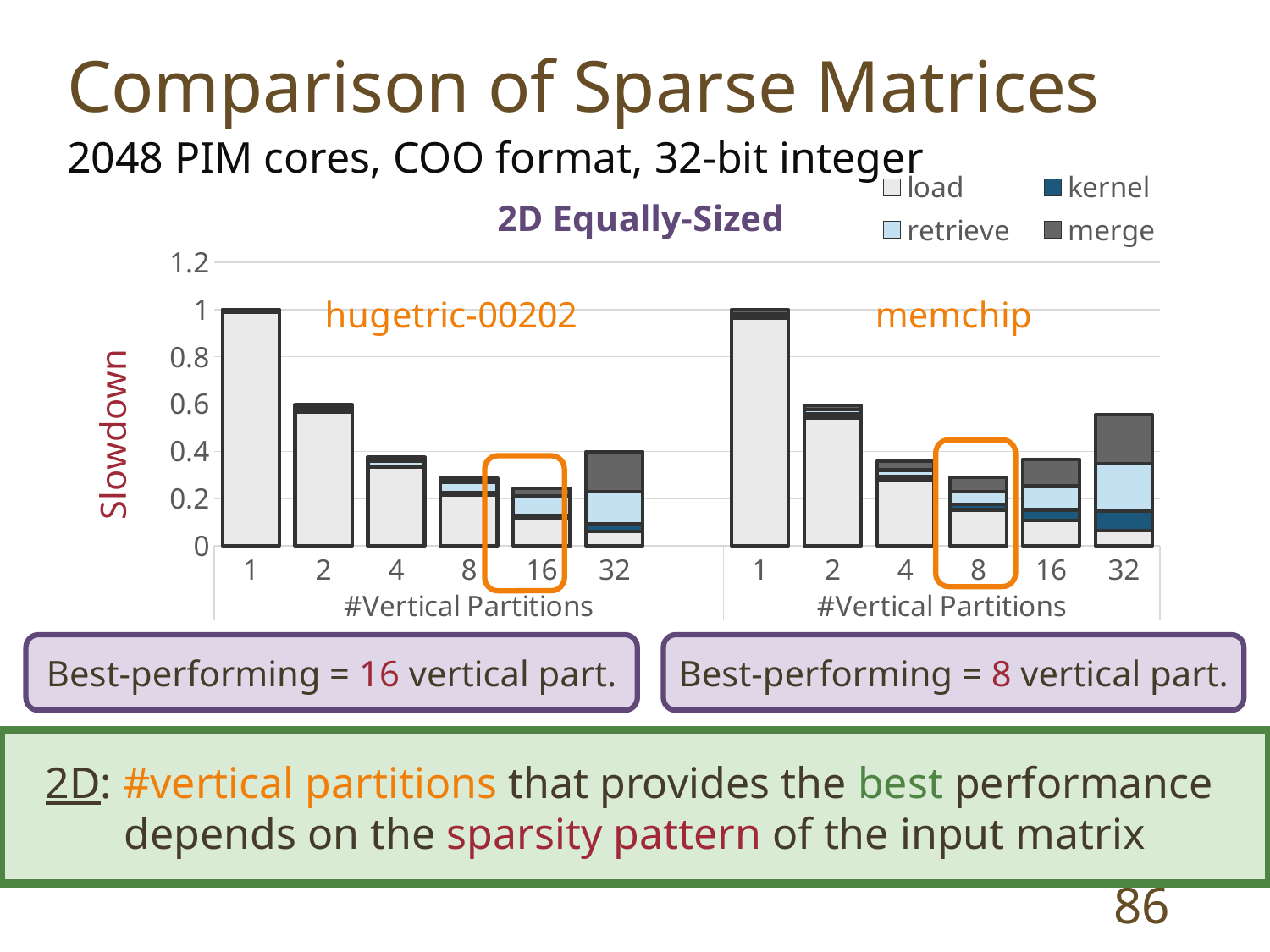
For the hugetric-00202 matrix, which number of vertical partitions has the lowest slowdown? 16 What are the series listed in the legend? load, kernel, retrieve, merge How many #Vertical Partitions categories are plotted for the hugetric-00202 matrix? 6 What kind of chart is shown on the slide? bar chart For the hugetric-00202 matrix, is the total slowdown at 16 vertical partitions greater or less than 0.2? greater For the hugetric-00202 matrix, which number of vertical partitions has the highest slowdown? 1 How many series does the legend list? 4 For the memchip matrix, is the total slowdown at 32 vertical partitions greater or less than 0.4? greater What is the title of the chart? 2D Equally-Sized For the memchip matrix, which number of vertical partitions has the lowest slowdown? 8 For the memchip matrix, which number of vertical partitions has the highest slowdown? 1 For the memchip matrix, which has the larger total slowdown: 16 or 32 vertical partitions? 32